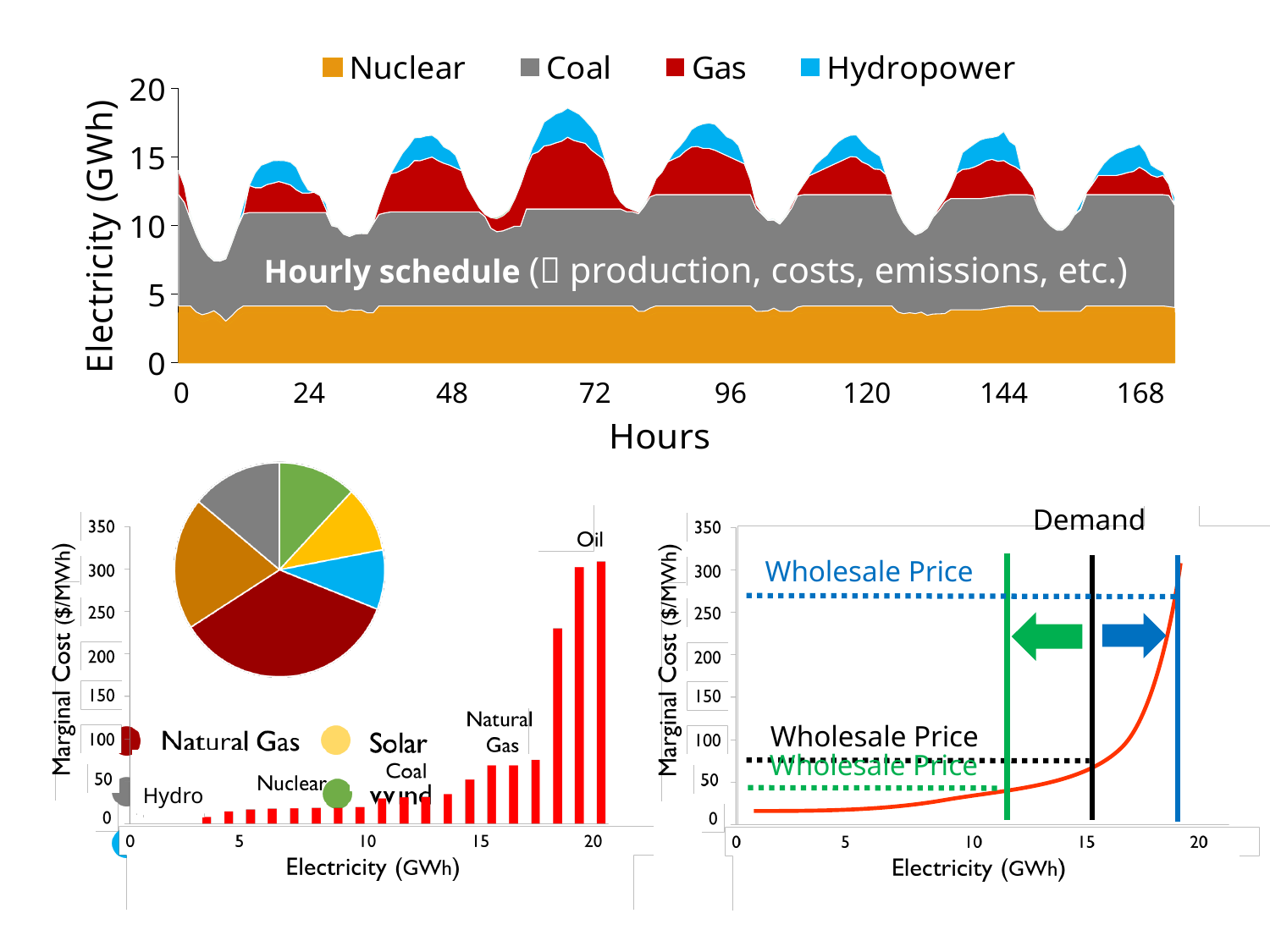
In the bottom-left chart of marginal cost versus electricity, which labelled technology has the tallest bars? Oil In the top chart of electricity by hour, how many series does the legend list? 4 In the bottom-right chart of marginal cost versus electricity, does the red marginal cost curve rise or fall as electricity increases? rise In the bottom-right chart of marginal cost versus electricity, is the blue dotted Wholesale Price line greater or less than 250 $/MWh? greater In the top chart of electricity by hour, is the total stacked value at its highest peak (around hour 66) greater or less than 15 GWh? greater In the top chart of electricity by hour, what kind of chart is it? stacked area chart In the top chart of electricity by hour, is the Nuclear layer at hour 24 greater or less than 5 GWh? less In the pie chart inset on the bottom-left chart, how many slices are there? 6 In the bottom-left chart of marginal cost versus electricity, what kind of chart shows the marginal cost values? bar chart In the top chart of electricity by hour, what is the label of the x axis? Hours In the top chart of electricity by hour, which series forms the bottom layer of the stack? Nuclear